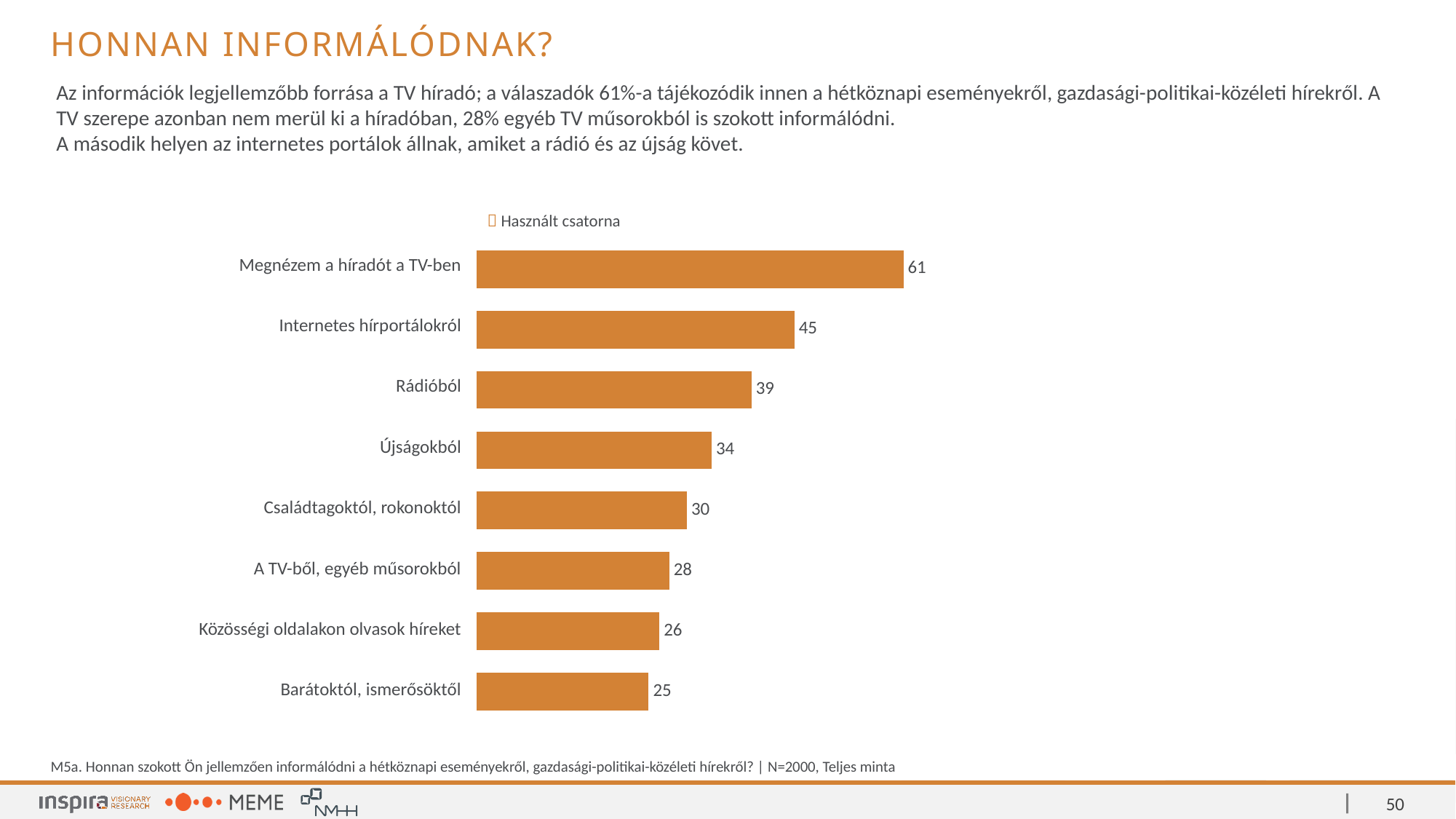
How many series does the legend list? 1 What is the difference between the values for "Megnézem a híradót a TV-ben" and "Barátoktól, ismerősöktől"? 36 What is the value for "Megnézem a híradót a TV-ben"? 61 Which is larger: the value for "Családtagoktól, rokonoktól" or "A TV-ből, egyéb műsorokból"? Családtagoktól, rokonoktól How many categories are shown in the chart? 8 What kind of chart is shown on the slide? Bar chart What is the value for "Rádióból"? 39 What is the value for "Közösségi oldalakon olvasok híreket"? 26 What is the legend entry of the chart? Használt csatorna What is the difference between the values for "Internetes hírportálokról" and "Újságokból"? 11 Which category has the highest value? Megnézem a híradót a TV-ben Which category has the lowest value? Barátoktól, ismerősöktől